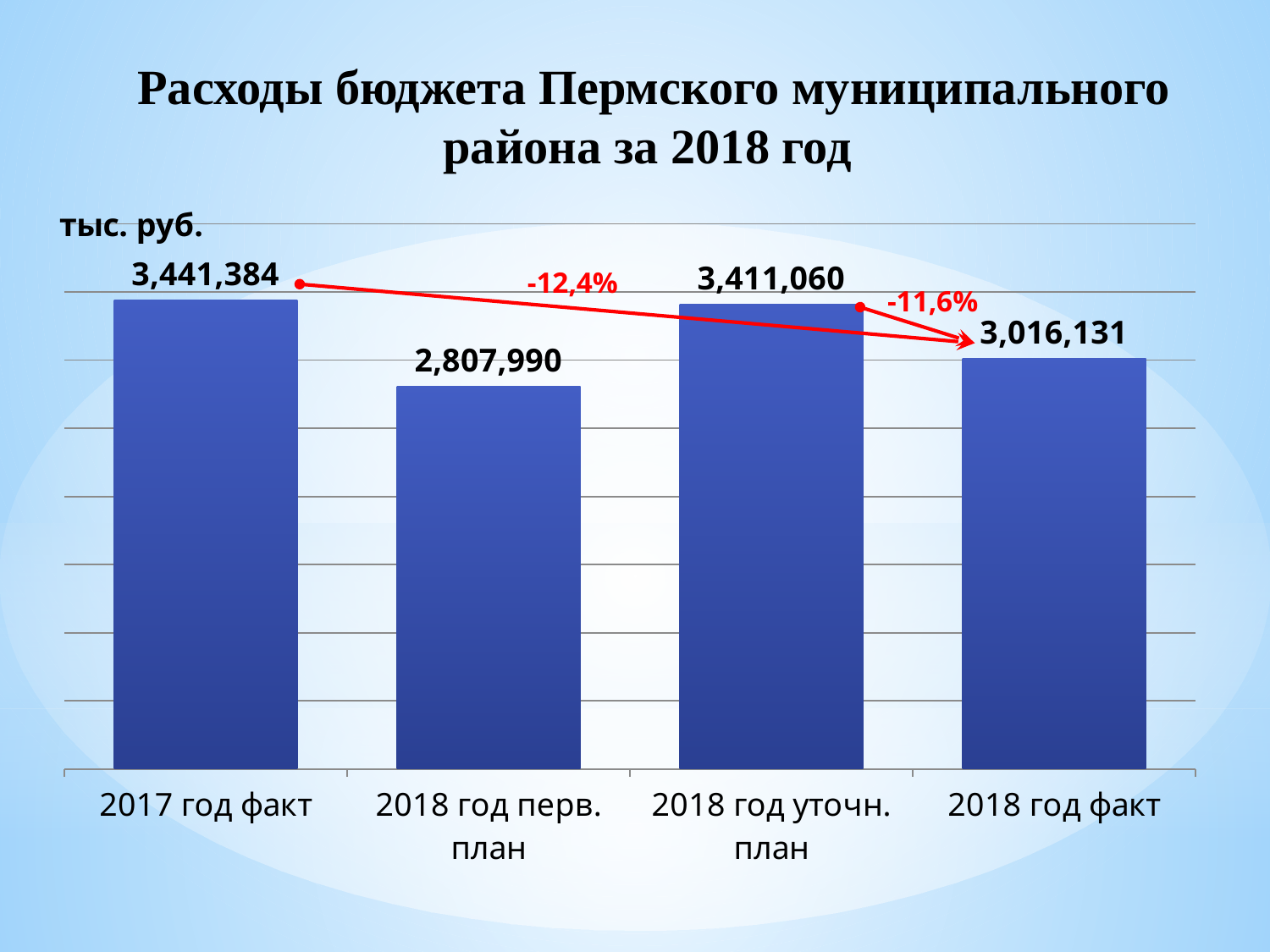
What is the difference between 2017 год факт and 2018 год перв. план? 633,394 Which category has the lowest value? 2018 год перв. план Which category has the highest value? 2017 год факт Which is larger, 2018 год факт or 2018 год перв. план? 2018 год факт What is the value for 2018 год уточн. план? 3,411,060 How many categories are shown on the chart? 4 What percentage change is annotated between 2017 год факт and 2018 год факт? -12,4% What is the value for 2017 год факт? 3,441,384 What is the difference between 2018 год уточн. план and 2018 год факт? 394,929 What kind of chart is shown on the slide? Bar chart What is the value for 2018 год факт? 3,016,131 What is the value for 2018 год перв. план? 2,807,990